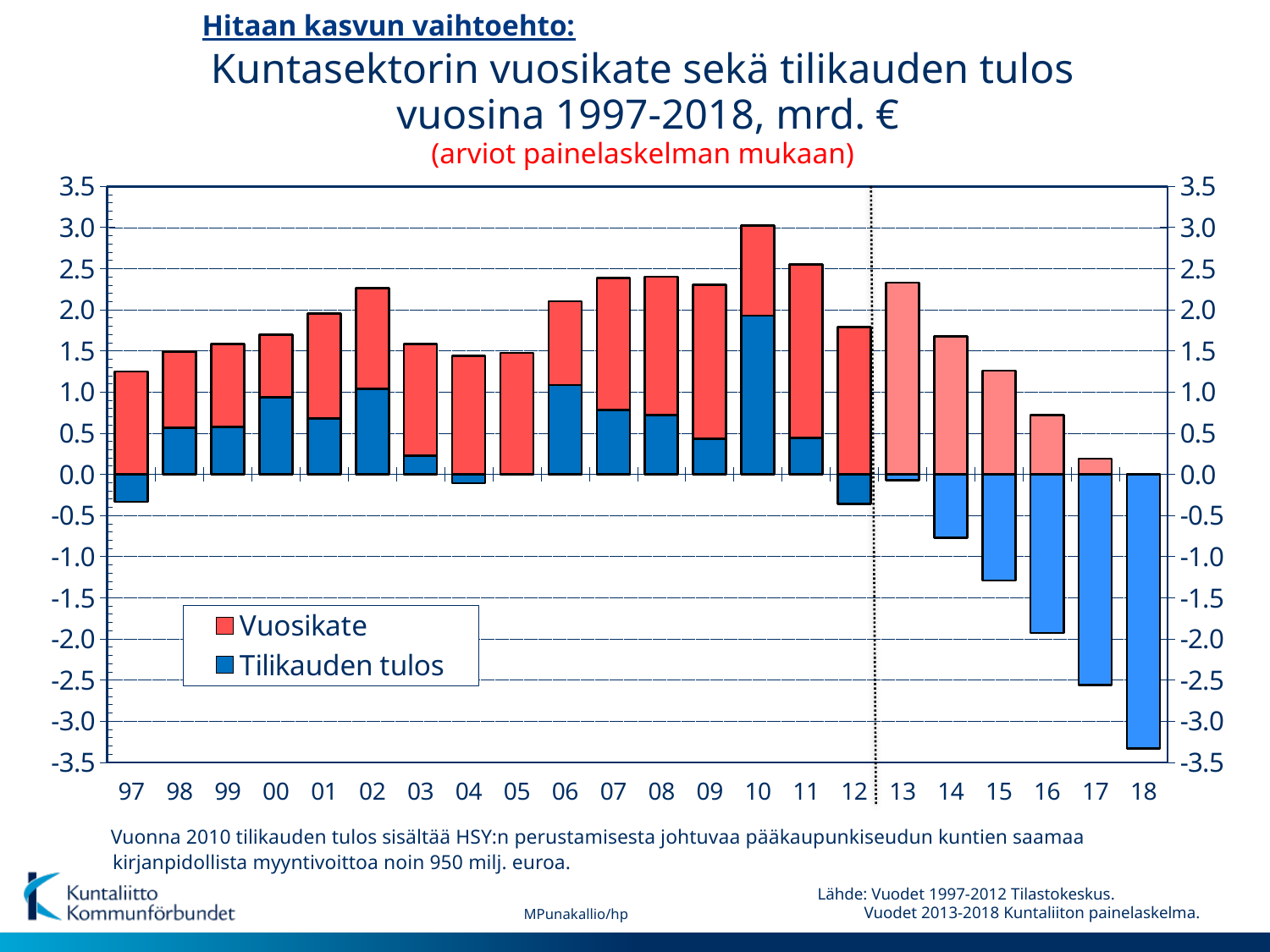
Which is larger, Vuosikate in 02 or Vuosikate in 03? 02 Is the value of Vuosikate for 16 greater or less than 1.0? less Is the value of Tilikauden tulos for 18 greater or less than -3.0? less What kind of chart is shown on the slide? bar chart In which year is Tilikauden tulos lowest? 18 Is the value of Vuosikate for 10 greater or less than 2.5? greater In which year is Vuosikate highest? 10 How many years are shown on the x axis? 22 Does Tilikauden tulos rise or fall from 13 to 18? fall In which year is Tilikauden tulos highest? 10 How many series does the legend list? 2 What are the two series named in the legend? Vuosikate and Tilikauden tulos